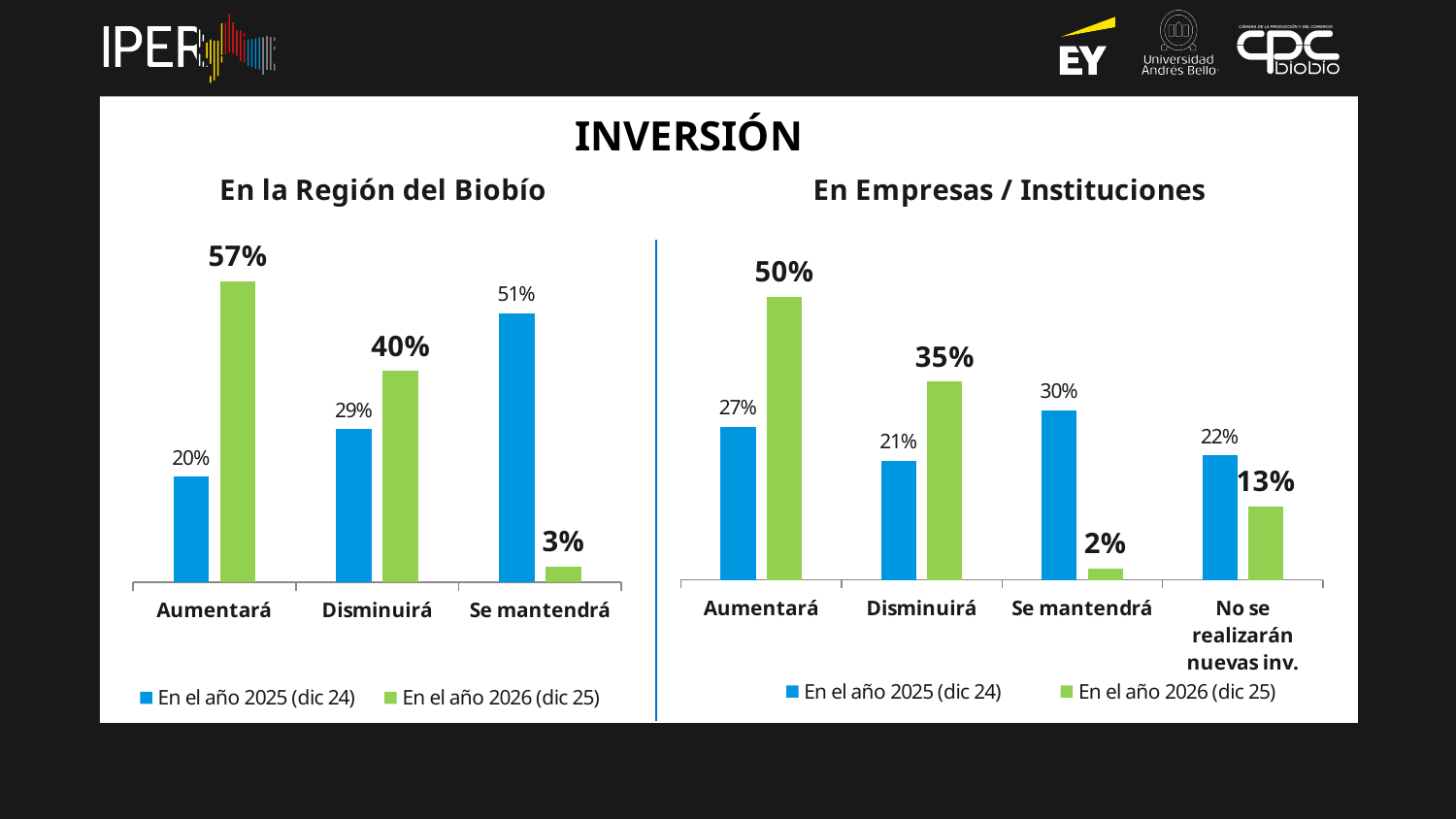
How many series does the legend of the 'En la Región del Biobío' chart list? 2 In the 'En Empresas / Instituciones' chart, what is the value for 'Disminuirá' in the 'En el año 2026 (dic 25)' series? 35% How many categories are shown on the x axis of the 'En Empresas / Instituciones' chart? 4 In the 'En la Región del Biobío' chart, what is the value for 'Se mantendrá' in the 'En el año 2025 (dic 24)' series? 51% In the 'En la Región del Biobío' chart, which category has the lowest value in the 'En el año 2026 (dic 25)' series? Se mantendrá In the 'En la Región del Biobío' chart, what is the value for 'Aumentará' in the 'En el año 2026 (dic 25)' series? 57% In the 'En Empresas / Instituciones' chart, what is the value for 'No se realizarán nuevas inv.' in the 'En el año 2025 (dic 24)' series? 22% In the 'En la Región del Biobío' chart, which is larger for 'Disminuirá': the 2025 value or the 2026 value? The 2026 value (40%) What type of chart is the 'En Empresas / Instituciones' chart? Bar chart In the 'En la Región del Biobío' chart, what is the difference between the 2026 and 2025 values for 'Aumentará'? 37 percentage points In the 'En Empresas / Instituciones' chart, which category has the highest value in the 'En el año 2026 (dic 25)' series? Aumentará In the 'En Empresas / Instituciones' chart, what is the difference between the 2025 and 2026 values for 'Se mantendrá'? 28 percentage points